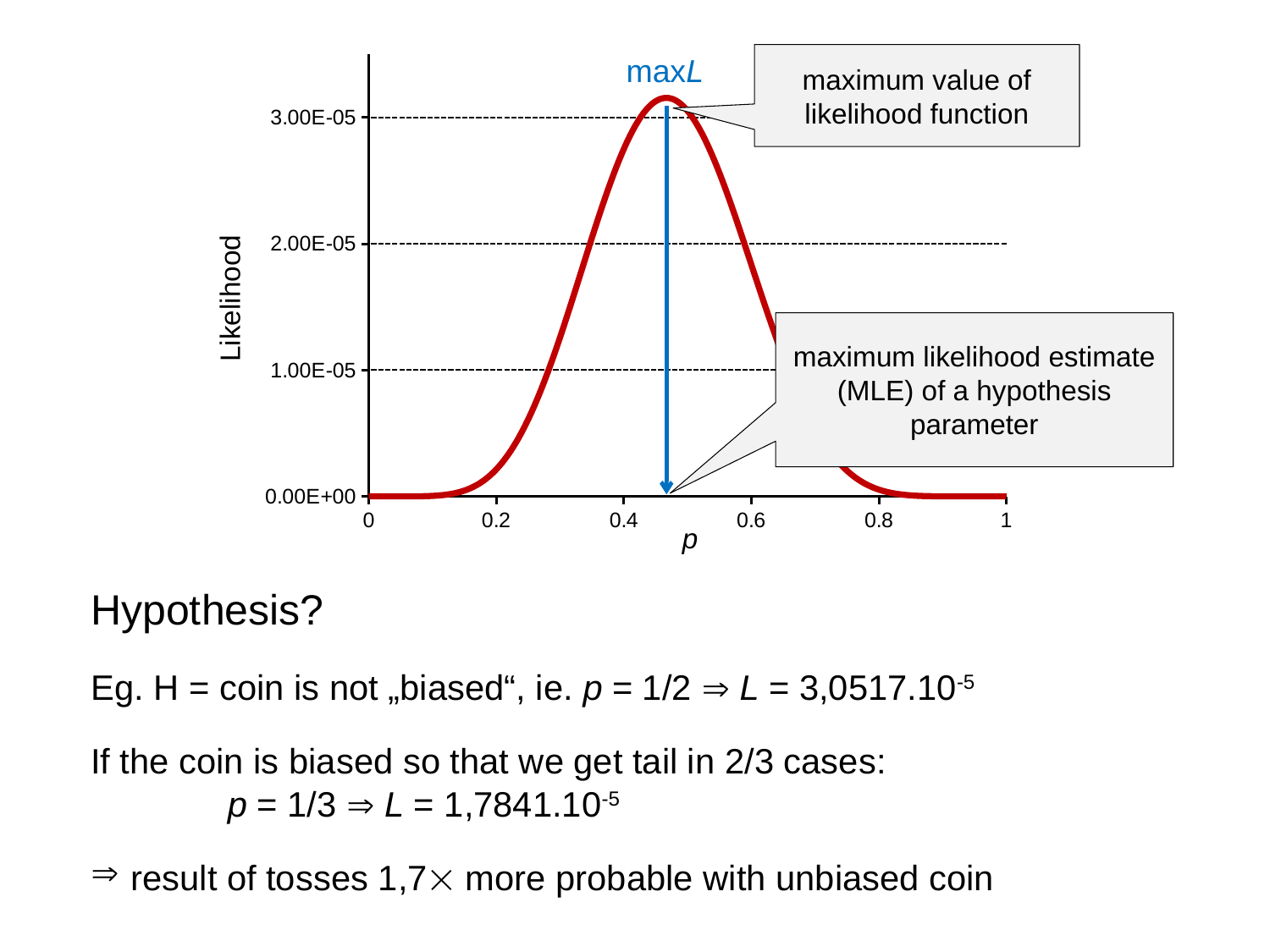
Is the likelihood at p = 0.4 greater or less than 2.00E-05? greater How many curves (series) are plotted on the chart? 1 Is the likelihood at p = 0.8 greater or less than 1.00E-05? less What is the label of the x axis of the chart? p Is the likelihood at p = 0.4 greater or less than 3.00E-05? less How does the likelihood change as p increases from 0 to 1? rises to a peak then falls What kind of chart is shown on the slide? line chart Which has the higher likelihood, p = 0.6 or p = 0.8? p = 0.6 Which has the higher likelihood, p = 0.4 or p = 0.2? p = 0.4 What is the label of the y axis of the chart? Likelihood